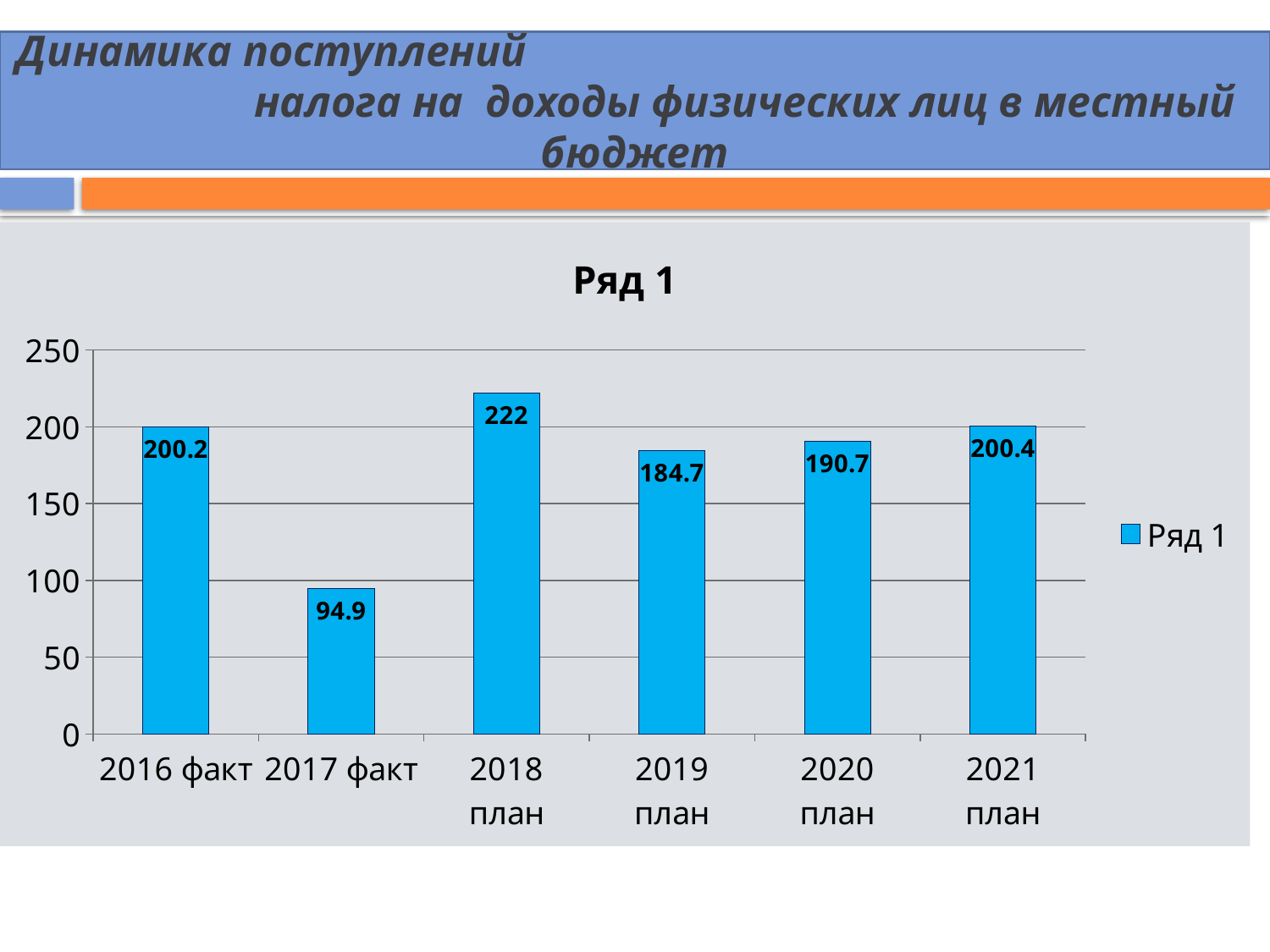
Which category has the lowest value? 2017 факт What is the difference between the values for 2018 план and 2019 план? 37.3 What is the title of the chart? Ряд 1 What is the difference between the values for 2016 факт and 2017 факт? 105.3 What kind of chart is shown on the slide? bar chart Which category has the highest value? 2018 план What is the value for 2020 план? 190.7 Which is larger, the value for 2019 план or the value for 2020 план? 2020 план How many categories are shown on the x axis? 6 What is the value for 2017 факт? 94.9 Is the value for 2017 факт greater or less than 100? less What is the value for 2018 план? 222